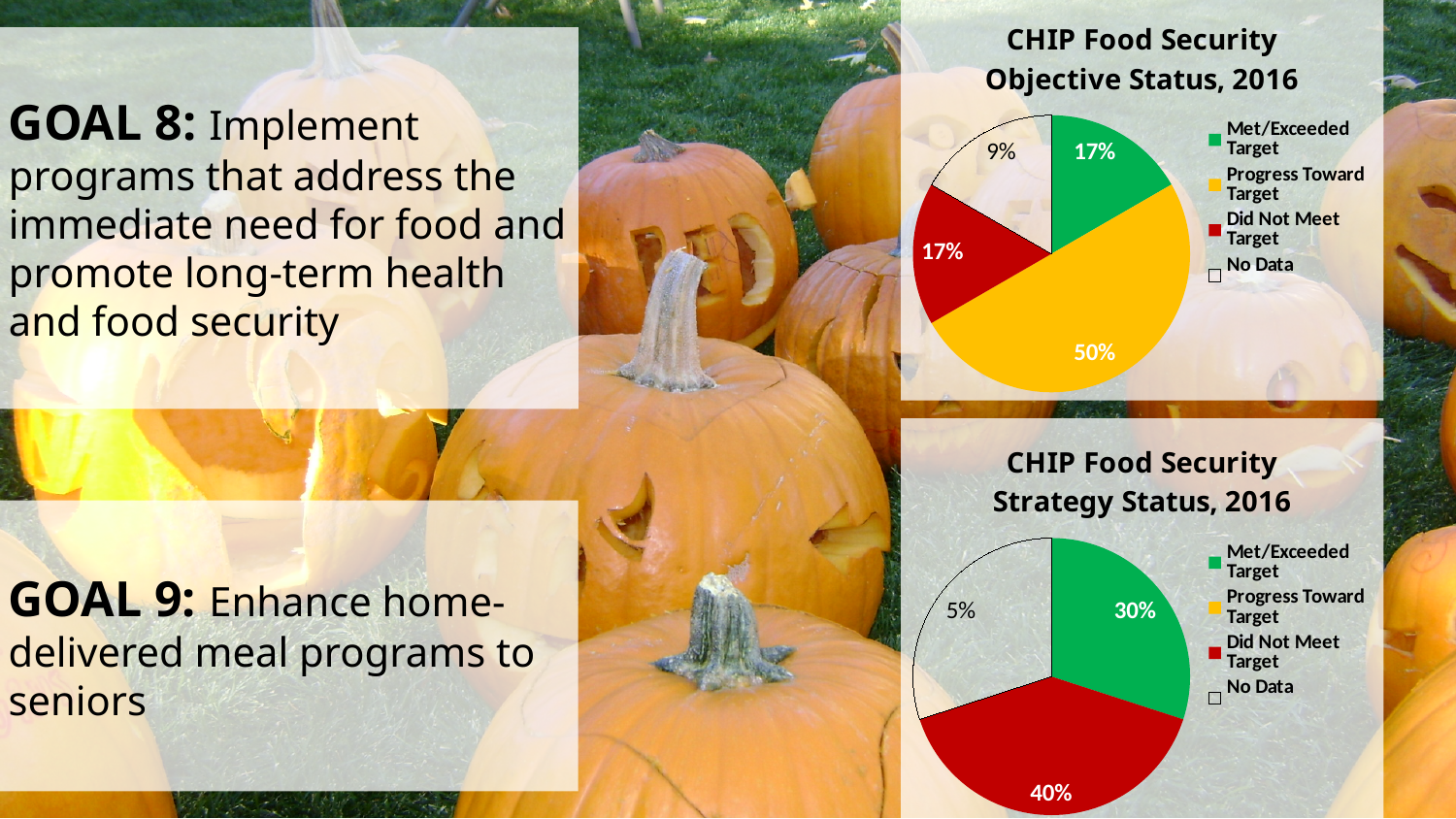
In the CHIP Food Security Strategy Status, 2016 chart, which is larger: Did Not Meet Target or Met/Exceeded Target? Did Not Meet Target What type of chart is the CHIP Food Security Objective Status, 2016 chart? Pie chart In the CHIP Food Security Strategy Status, 2016 chart, what percentage is Did Not Meet Target? 40% In the CHIP Food Security Objective Status, 2016 chart, what percentage is labelled No Data? 9% In the CHIP Food Security Objective Status, 2016 chart, what percentage is Met/Exceeded Target? 17% In the CHIP Food Security Strategy Status, 2016 chart, what colour represents Did Not Meet Target? Red In the CHIP Food Security Objective Status, 2016 chart, how many percentage points larger is Progress Toward Target than Met/Exceeded Target? 33 percentage points How many categories does the legend of the CHIP Food Security Objective Status, 2016 chart list? 4 In the CHIP Food Security Strategy Status, 2016 chart, what percentage is Met/Exceeded Target? 30% In the CHIP Food Security Objective Status, 2016 chart, what share of objectives are in Progress Toward Target? 50% In the CHIP Food Security Objective Status, 2016 chart, which category has the largest slice? Progress Toward Target